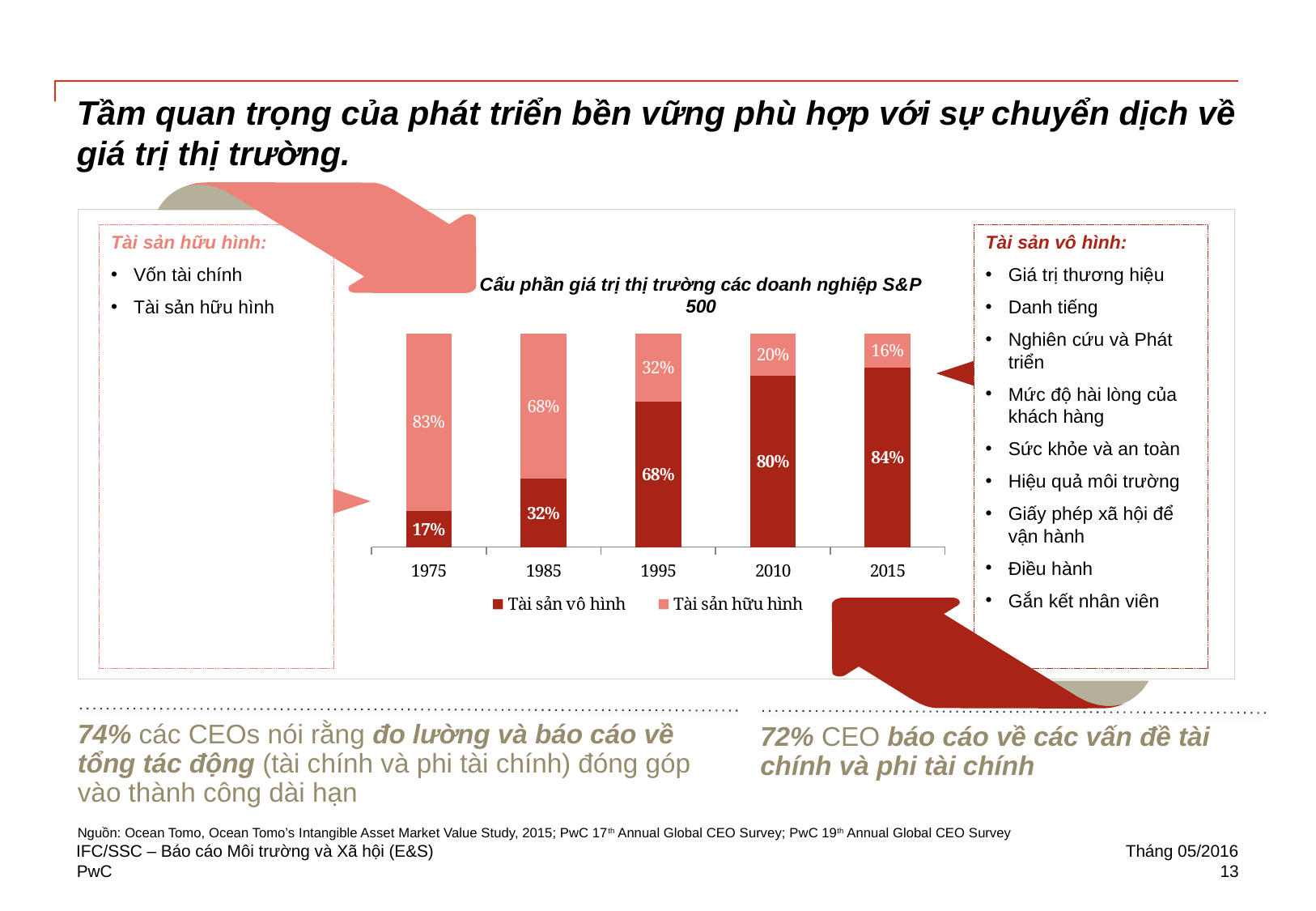
What is the value for Tài sản vô hình in 2015? 84% What kind of chart is shown? Stacked bar chart In which year is Tài sản hữu hình lowest? 2015 What is the value for Tài sản hữu hình in 2010? 20% What is the difference between Tài sản vô hình in 2015 and in 1975? 67% How many years are shown on the x axis? 5 How many series does the legend list? 2 What is the value for Tài sản vô hình in 1975? 17% Which is larger in 1995: Tài sản vô hình or Tài sản hữu hình? Tài sản vô hình Does the share of Tài sản vô hình rise or fall from 1975 to 2015? Rise In which year is Tài sản vô hình highest? 2015 What is the value for Tài sản hữu hình in 1985? 68%